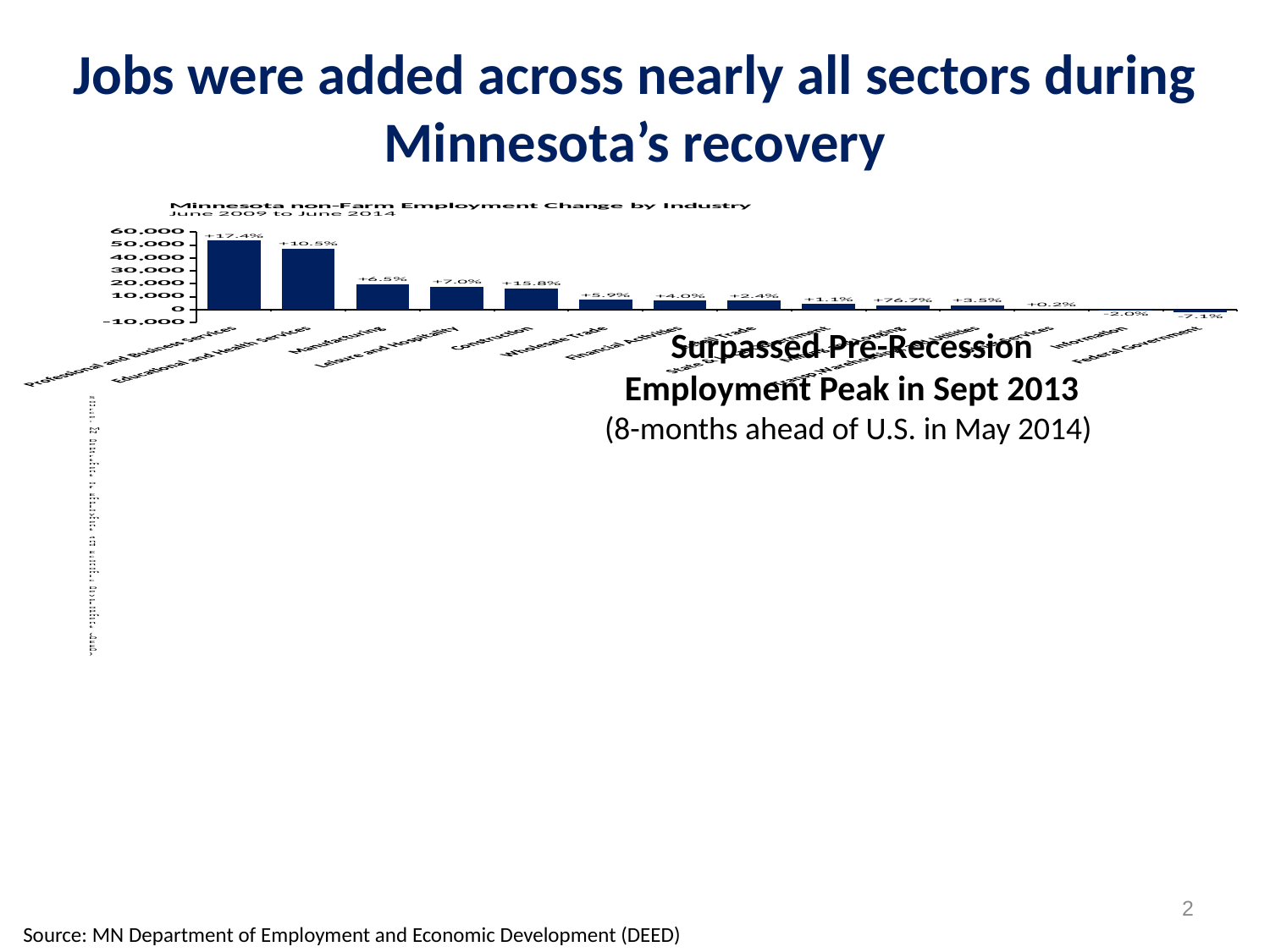
Which industry has the lowest bar in the chart? Federal Government What is the title of the chart? Minnesota non-Farm Employment Change by Industry Which industry has the tallest bar in the chart? Professional and Business Services What percentage change is labelled on the bar for Information? -2.0% Is the bar for Professional and Business Services greater or less than 40,000? greater Which bar is taller, Manufacturing or Construction? Manufacturing What percentage change is labelled on the bar for Manufacturing? +6.5% What percentage change is labelled on the bar for Federal Government? -7.1% What kind of chart is shown on the slide? bar chart What percentage change is labelled on the bar for Construction? +15.8% What percentage change is labelled on the bar for Professional and Business Services? +17.4% What time period does the chart subtitle say the employment change covers? June 2009 to June 2014